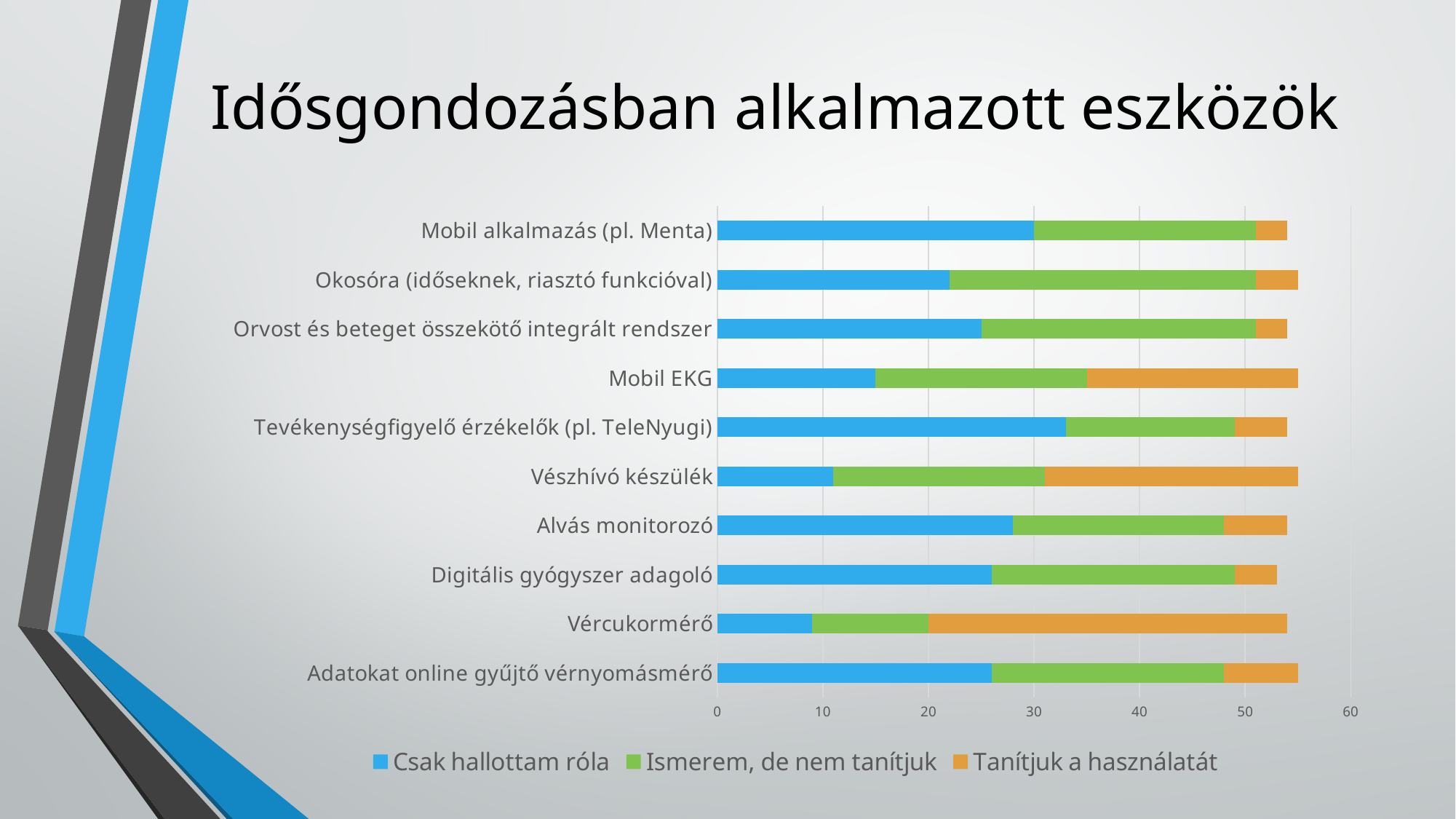
How many series does the legend list? 3 How many categories (devices) are listed on the chart? 10 Which has the larger 'Csak hallottam róla' segment: Mobil EKG or Mobil alkalmazás (pl. Menta)? Mobil alkalmazás (pl. Menta) Which has the larger 'Tanítjuk a használatát' segment: Vércukormérő or Vészhívó készülék? Vércukormérő What is the title of the slide? Idősgondozásban alkalmazott eszközök Is the 'Csak hallottam róla' value for Mobil alkalmazás (pl. Menta) greater or less than 20? greater What kind of chart is shown on the slide? Stacked bar chart Is the 'Csak hallottam róla' value for Mobil EKG greater or less than 20? less Is the 'Csak hallottam róla' value for Vércukormérő greater or less than 10? less Which category has the largest 'Tanítjuk a használatát' segment? Vércukormérő Which series is shown in orange in the legend? Tanítjuk a használatát